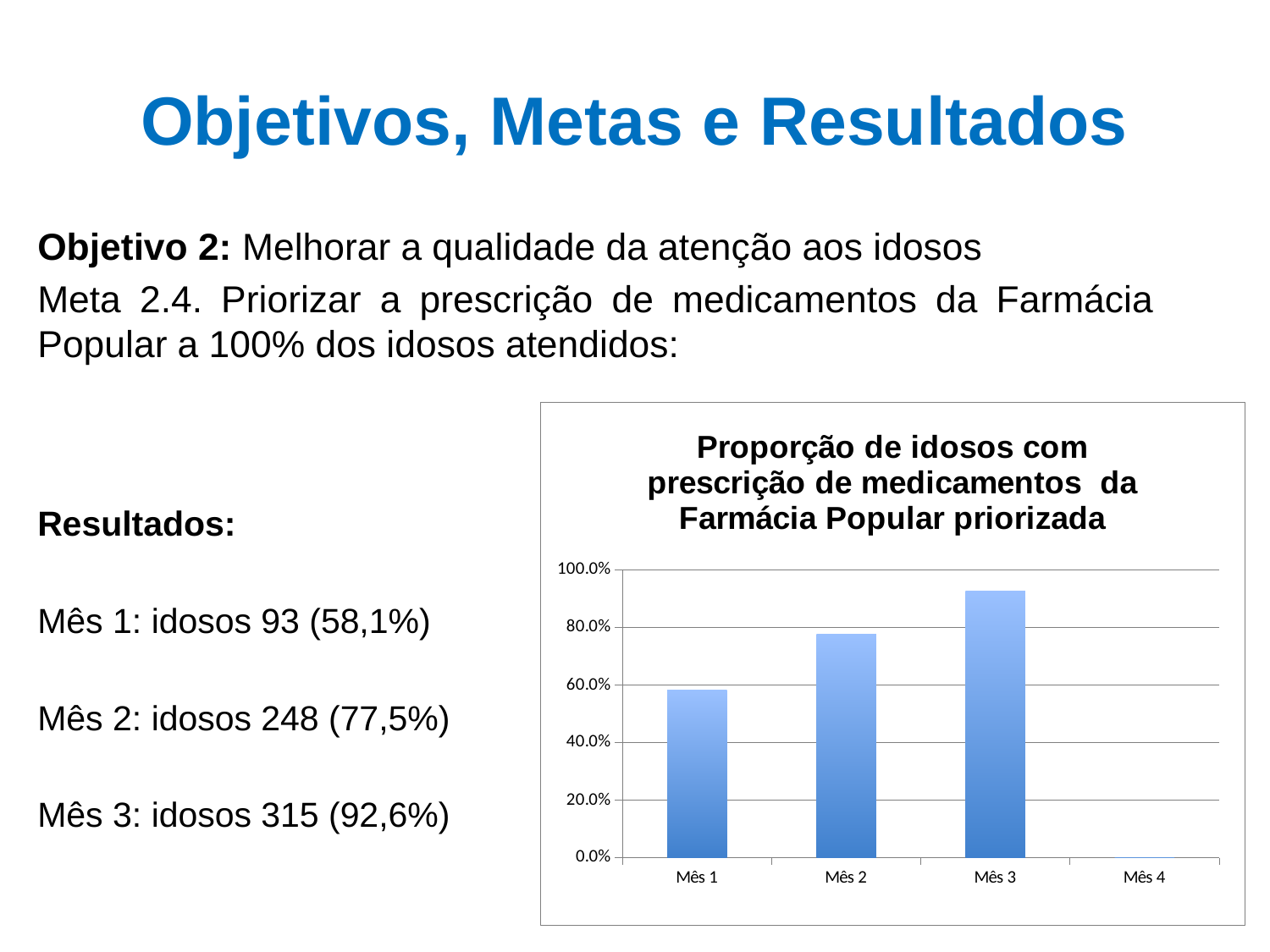
Is the value for Mês 3 greater or less than 80.0%? greater Which month has the highest bar in the chart? Mês 3 Among the months with a plotted bar, which has the lowest value? Mês 1 What kind of chart is shown on the slide? bar chart How many bars are plotted in the chart? 3 What is the highest value shown on the y axis of the chart? 100.0% Is the value for Mês 1 greater or less than 60.0%? less Which is larger, the value for Mês 2 or the value for Mês 3? Mês 3 Do the bar values rise or fall from Mês 1 to Mês 3? rise How many categories are shown on the x axis of the chart? 4 Is the value for Mês 2 greater or less than 60.0%? greater What is the title of the chart? Proporção de idosos com prescrição de medicamentos da Farmácia Popular priorizada